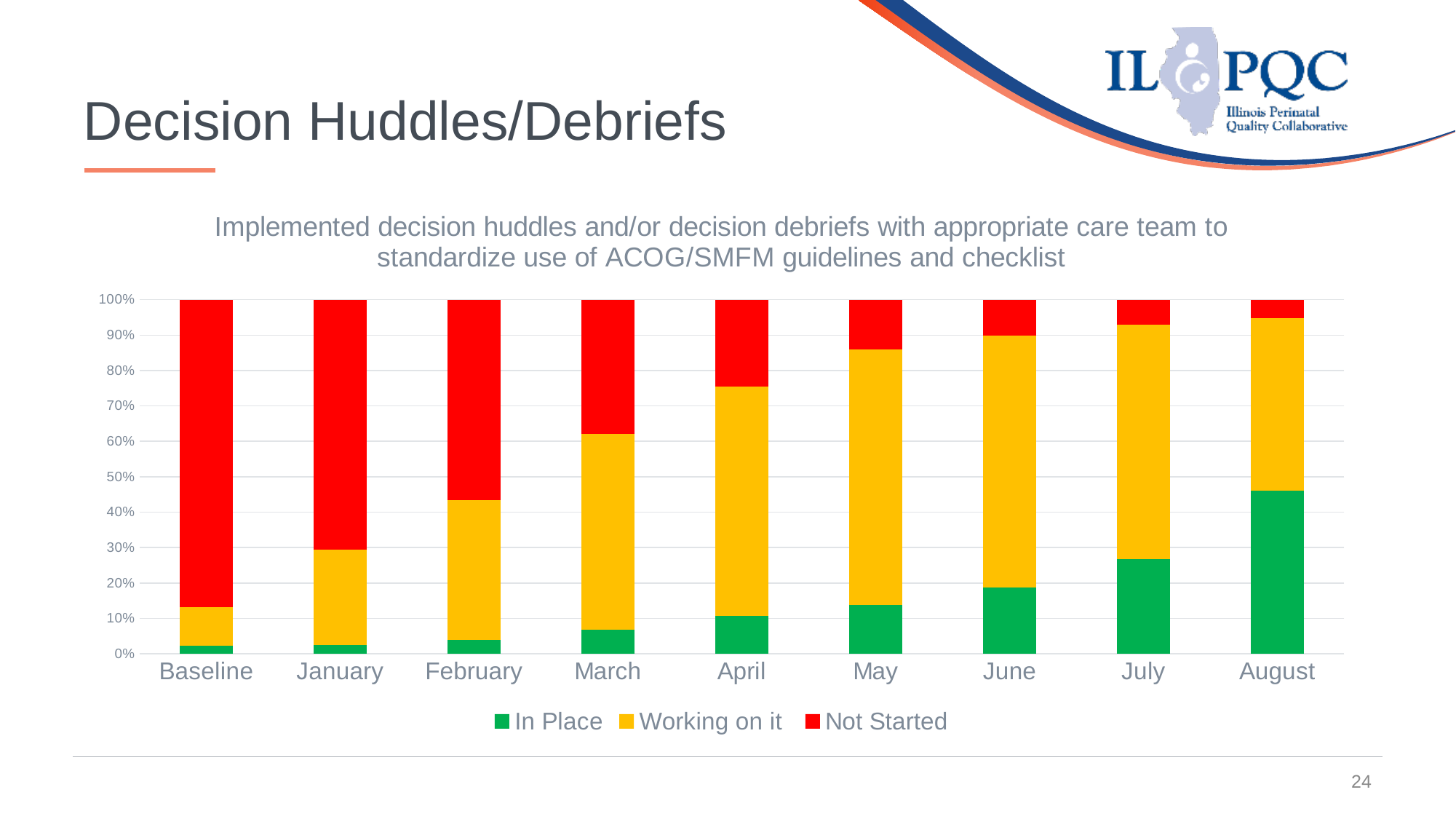
How many series does the legend list? 3 Is the In Place value for July greater or less than 20%? greater Which is larger, the Not Started share in February or in March? February Does the In Place share rise or fall from Baseline to August? Rise What kind of chart is shown on the slide? Stacked bar chart Is the Not Started value for April greater or less than 30%? less In which month is the In Place share the highest? August Is the In Place value for August greater or less than 40%? greater Which series is shown in green in the legend? In Place How many categories are shown along the x axis? 9 Which is larger, the In Place share in May or in June? June Which category has the largest Not Started share? Baseline